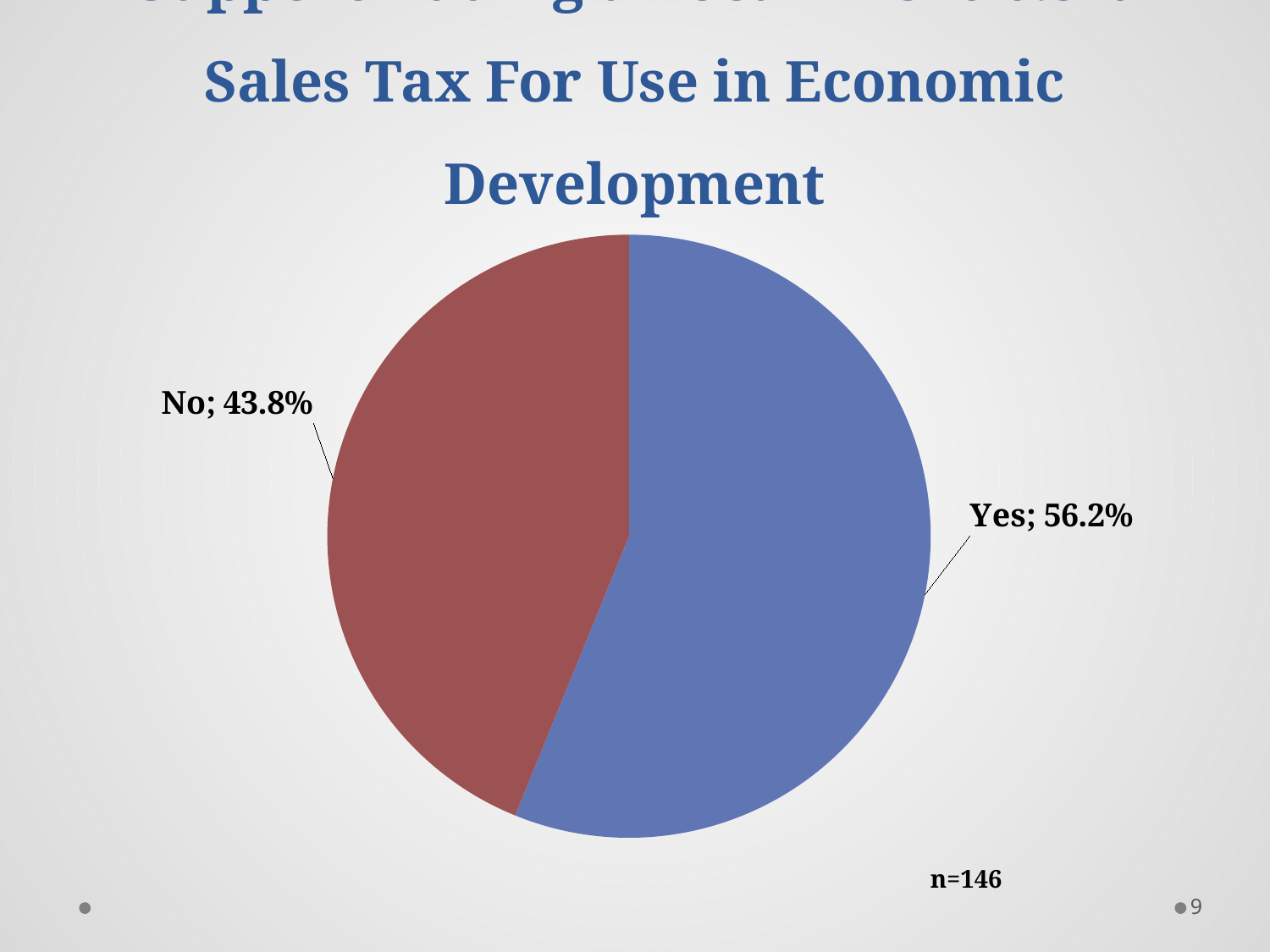
Is the share for "No" greater or less than 50%? less What is the difference in percentage points between the "Yes" and "No" slices? 12.4 How many slices does the pie chart have? 2 Which is larger, the "Yes" slice or the "No" slice? Yes What is the sample size (n) shown below the chart? n=146 What kind of chart is shown on the slide? Pie chart What share of the pie does the "Yes" slice represent? 56.2% Is the share for "Yes" greater or less than 50%? greater Which slice of the pie is the smallest? No Which slice of the pie is the largest? Yes What share of the pie does the "No" slice represent? 43.8% What colour is the "No" slice of the pie? Red